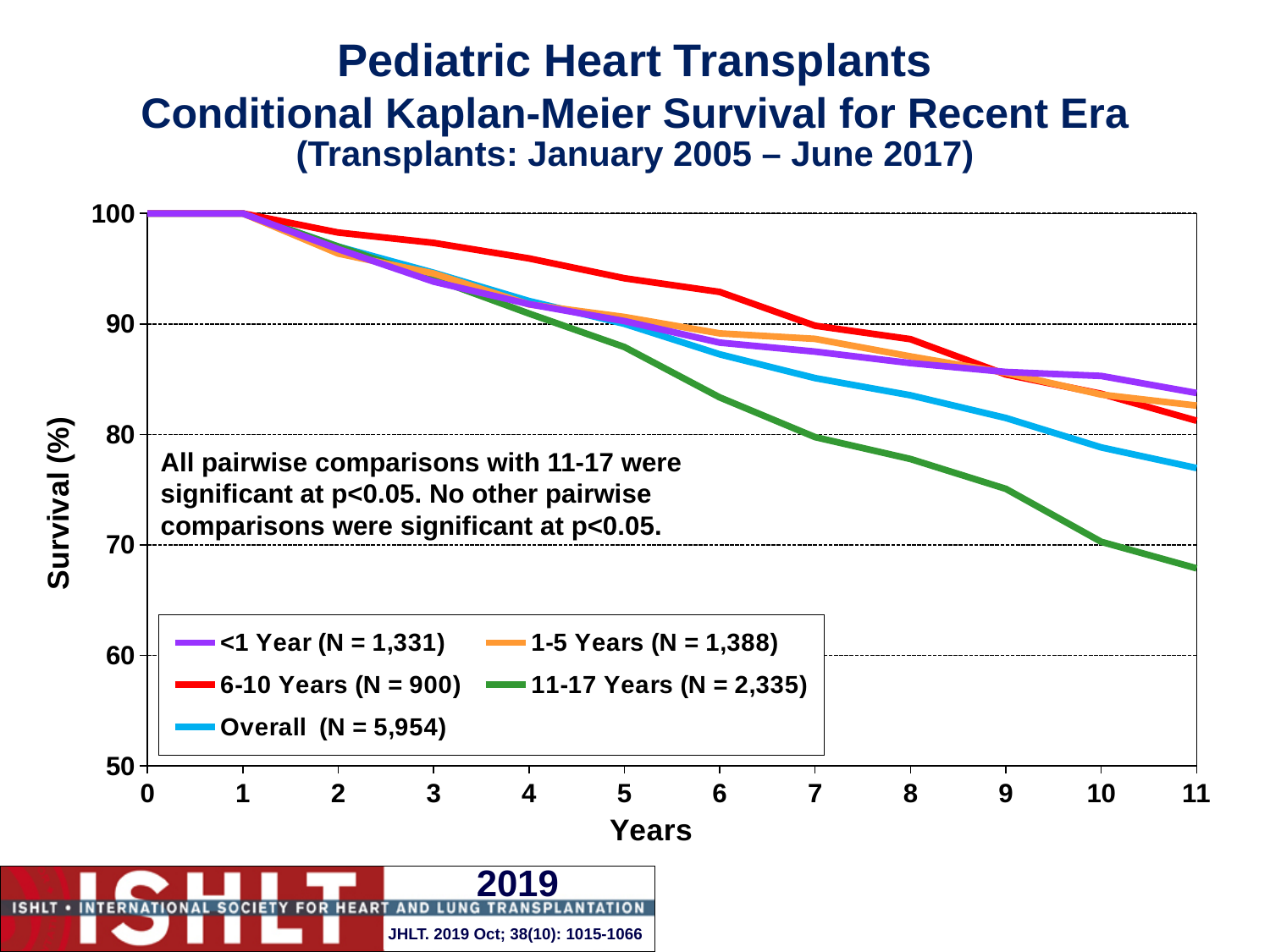
What is the N for the Overall group shown in the legend? 5,954 Is the survival value for Overall at year 11 greater or less than 80? less Is the survival value for 6-10 Years at year 5 greater or less than 90? greater Which group has the highest survival at year 5? 6-10 Years Do the survival curves rise or fall as the years increase? fall What is the survival value for all groups at year 0? 100 How many series does the legend list? 5 What is the label of the y axis? Survival (%) What kind of chart is shown on the slide? line chart Is the survival value for 11-17 Years at year 11 greater or less than 70? less Which group has the lowest survival at year 11? 11-17 Years At year 8, which has higher survival: 6-10 Years or 11-17 Years? 6-10 Years